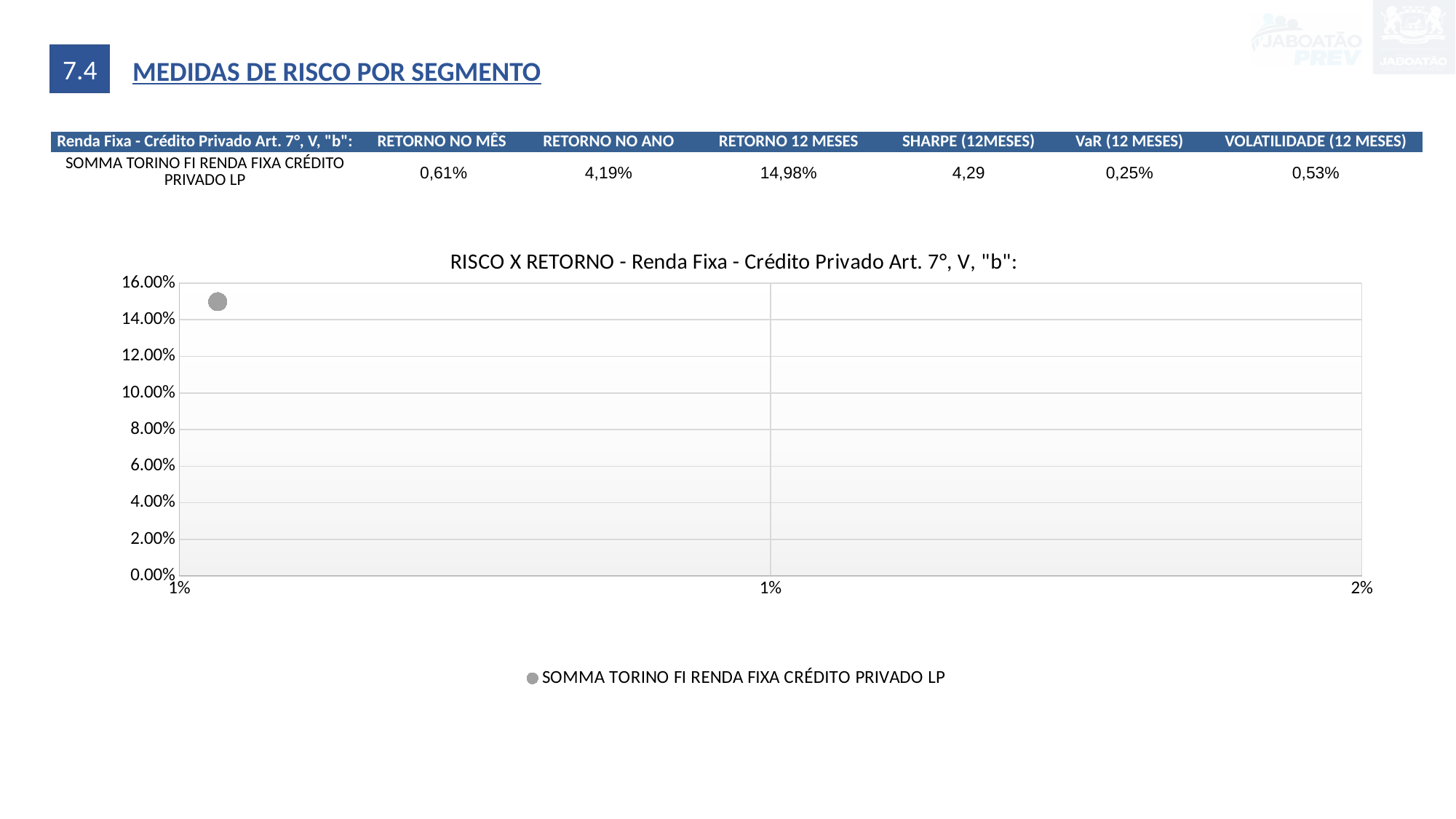
What is the highest tick label on the vertical axis of the RISCO X RETORNO chart? 16.00% How many series does the legend of the RISCO X RETORNO chart list? 1 What is the name of the series shown in the legend of the RISCO X RETORNO chart? SOMMA TORINO FI RENDA FIXA CRÉDITO PRIVADO LP What is the title of the chart on the slide? RISCO X RETORNO - Renda Fixa - Crédito Privado Art. 7°, V, "b": What kind of chart is shown under the title "RISCO X RETORNO - Renda Fixa - Crédito Privado Art. 7°, V, "b":"? scatter chart Is the plotted point for SOMMA TORINO FI RENDA FIXA CRÉDITO PRIVADO LP in the RISCO X RETORNO chart greater or less than 14.00% on the vertical axis? greater How many data points are plotted in the RISCO X RETORNO chart? 1 Is the plotted point in the RISCO X RETORNO chart greater or less than 10.00% on the vertical axis? greater Is the plotted point for SOMMA TORINO FI RENDA FIXA CRÉDITO PRIVADO LP in the RISCO X RETORNO chart greater or less than 16.00% on the vertical axis? less